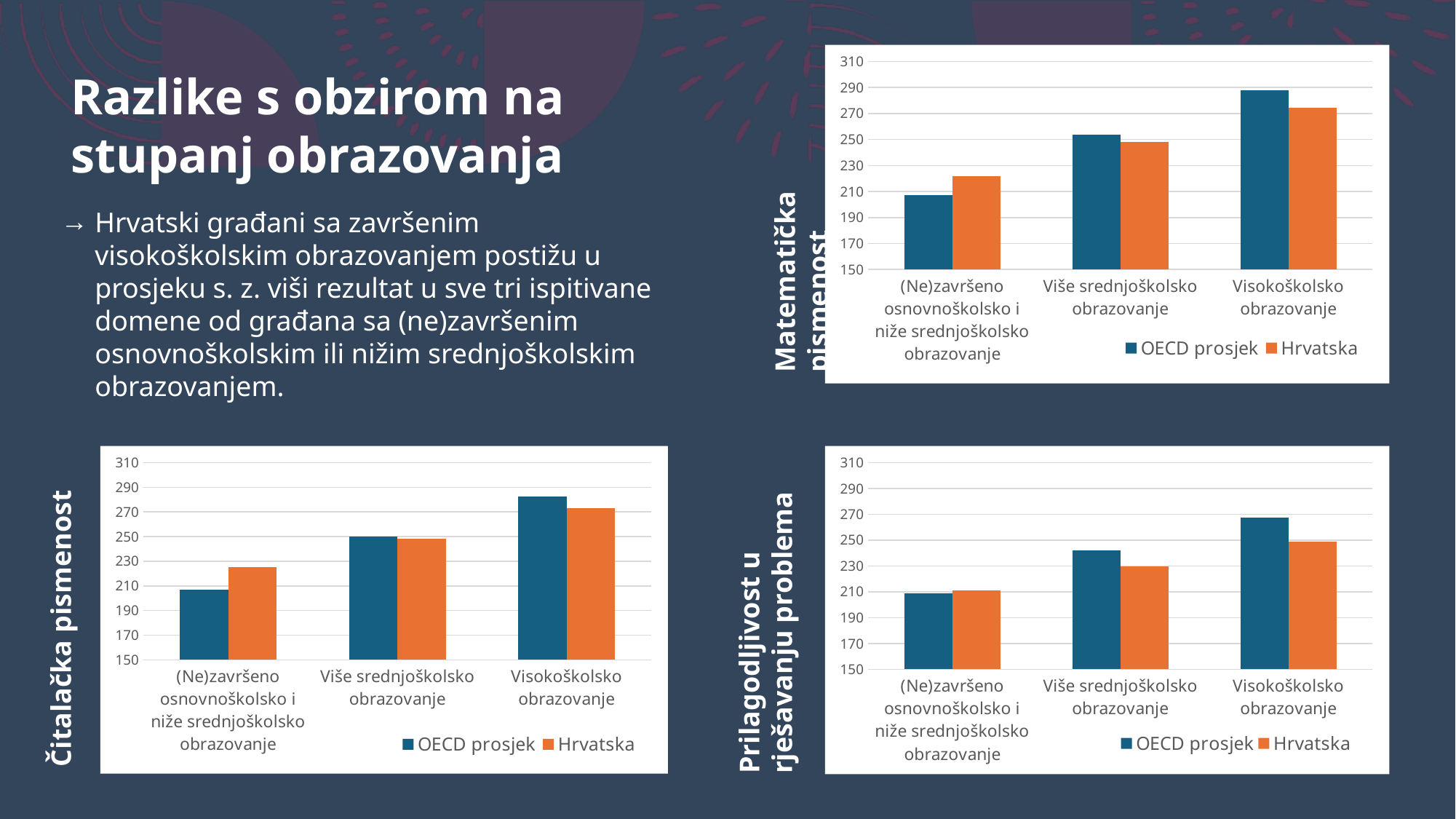
In the 'Matematička pismenost' chart, is the OECD prosjek value for Visokoškolsko obrazovanje greater or less than 270? greater What colour are the Hrvatska bars in the 'Čitalačka pismenost' chart? orange In the 'Matematička pismenost' chart, do the OECD prosjek values rise or fall from left to right along the x axis? rise How many series does the legend of the 'Prilagodljivost u rješavanju problema' chart list? 2 In the 'Matematička pismenost' chart, which is larger for (Ne)završeno osnovnoškolsko i niže srednjoškolsko obrazovanje: OECD prosjek or Hrvatska? Hrvatska In the 'Čitalačka pismenost' chart, is the OECD prosjek value for Visokoškolsko obrazovanje greater or less than 270? greater How many categories are shown on the x axis of the 'Čitalačka pismenost' chart? 3 In the 'Prilagodljivost u rješavanju problema' chart, is the OECD prosjek value for Više srednjoškolsko obrazovanje greater or less than 230? greater In the 'Prilagodljivost u rješavanju problema' chart, which is larger for Visokoškolsko obrazovanje: OECD prosjek or Hrvatska? OECD prosjek In the 'Čitalačka pismenost' chart, which category has the highest Hrvatska value? Visokoškolsko obrazovanje What kind of chart is the 'Matematička pismenost' chart? bar chart